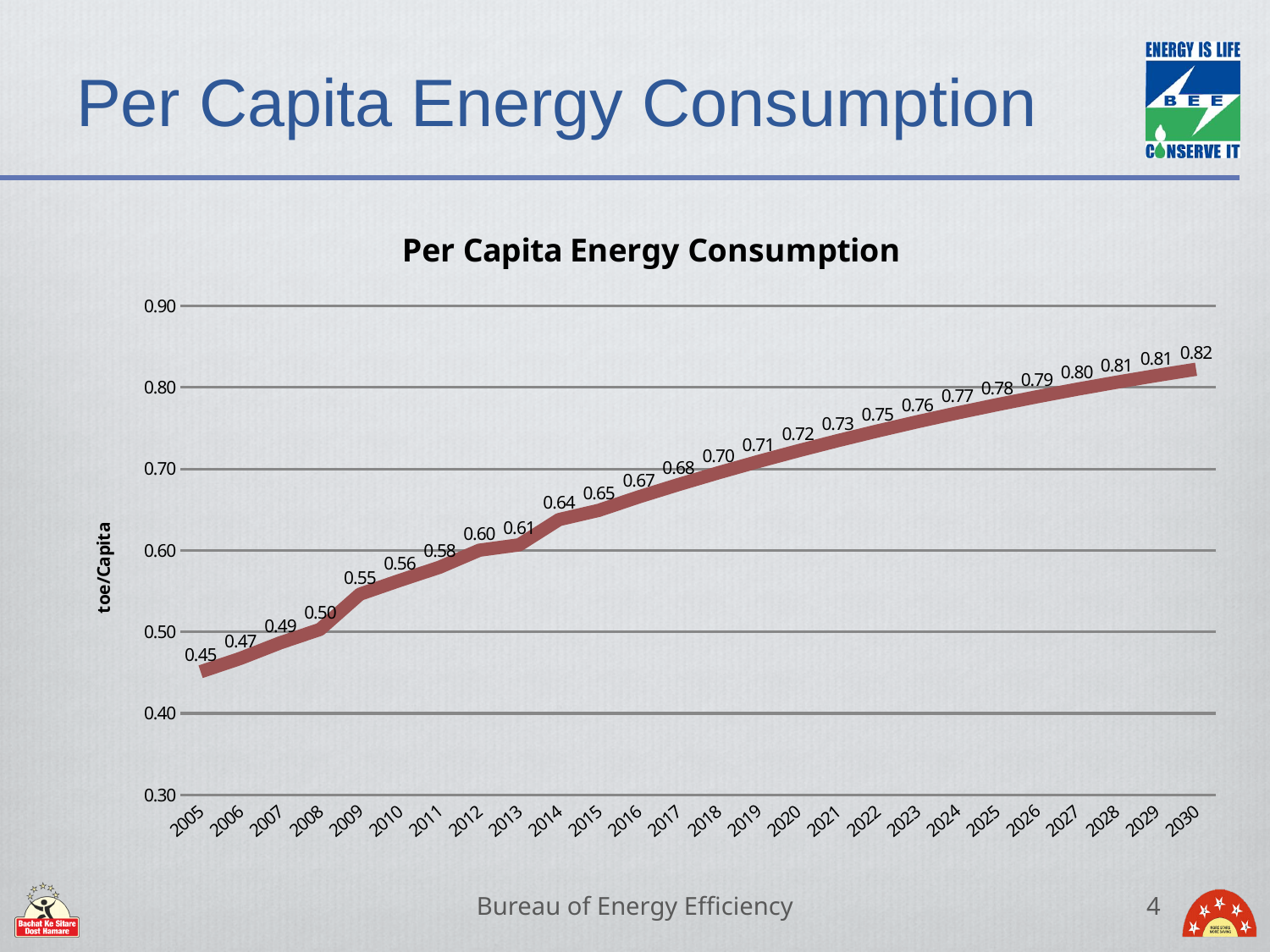
What is the value shown for 2022? 0.75 Which year has the highest per capita energy consumption? 2030 What is the per capita energy consumption value for 2005? 0.45 Do the values rise or fall from 2005 to 2030? Rise Which is larger, the value for 2009 or the value for 2013? 2013 What is the difference between the values for 2030 and 2005? 0.37 What is the value plotted for 2030? 0.82 How many years are plotted on the x axis? 26 Which year has the lowest per capita energy consumption? 2005 What is the label on the vertical axis? toe/Capita What type of chart is shown on the slide? Line chart What is the value shown for 2014? 0.64